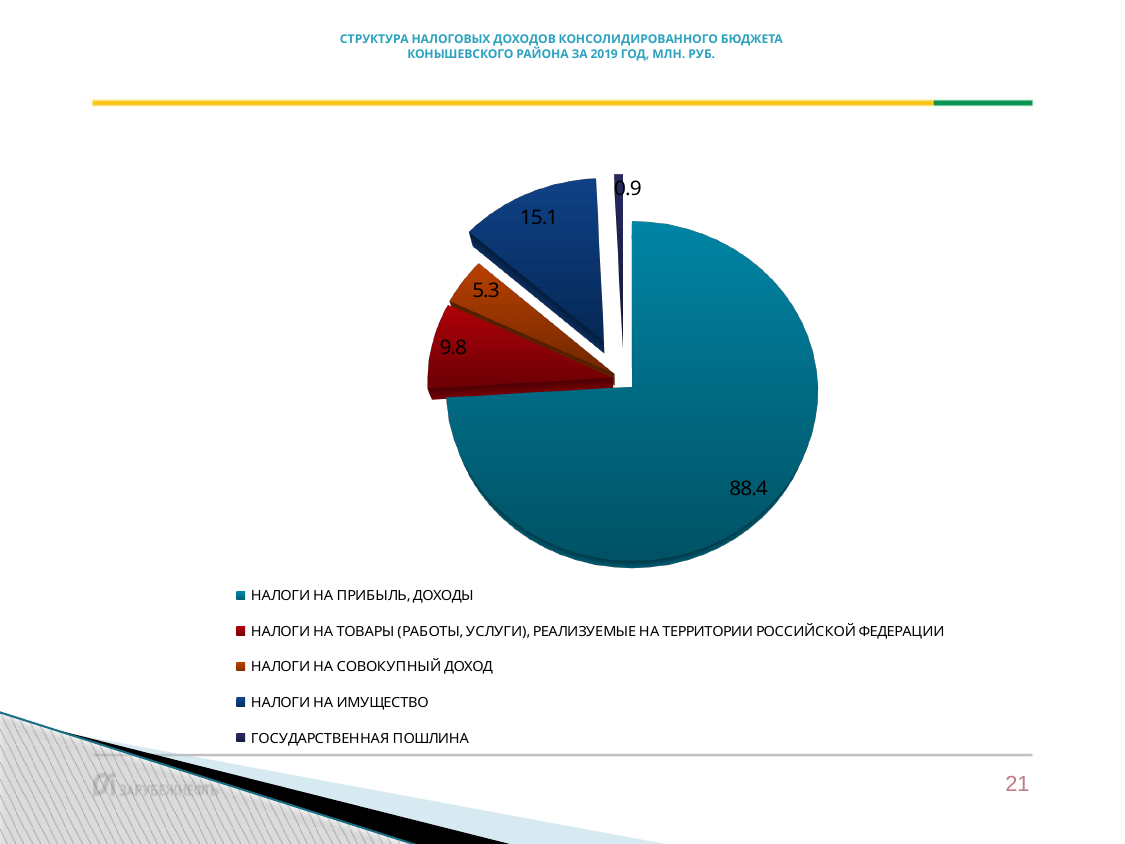
What is the value for НАЛОГИ НА ПРИБЫЛЬ, ДОХОДЫ? 88.4 What is the value for НАЛОГИ НА ИМУЩЕСТВО? 15.1 What is the value for ГОСУДАРСТВЕННАЯ ПОШЛИНА? 0.9 Which category has the smallest slice of the pie? ГОСУДАРСТВЕННАЯ ПОШЛИНА What is the value for НАЛОГИ НА СОВОКУПНЫЙ ДОХОД? 5.3 What is the difference between the values for НАЛОГИ НА ПРИБЫЛЬ, ДОХОДЫ and НАЛОГИ НА ИМУЩЕСТВО? 73.3 How many categories does the pie chart show? 5 Which is larger: НАЛОГИ НА ИМУЩЕСТВО or НАЛОГИ НА ТОВАРЫ (РАБОТЫ, УСЛУГИ), РЕАЛИЗУЕМЫЕ НА ТЕРРИТОРИИ РОССИЙСКОЙ ФЕДЕРАЦИИ? НАЛОГИ НА ИМУЩЕСТВО Which category has the largest slice of the pie? НАЛОГИ НА ПРИБЫЛЬ, ДОХОДЫ What unit of measurement is stated in the chart title? млн. руб. What is the difference between the values for НАЛОГИ НА ТОВАРЫ (РАБОТЫ, УСЛУГИ), РЕАЛИЗУЕМЫЕ НА ТЕРРИТОРИИ РОССИЙСКОЙ ФЕДЕРАЦИИ and НАЛОГИ НА СОВОКУПНЫЙ ДОХОД? 4.5 What kind of chart is shown on the slide? Pie chart